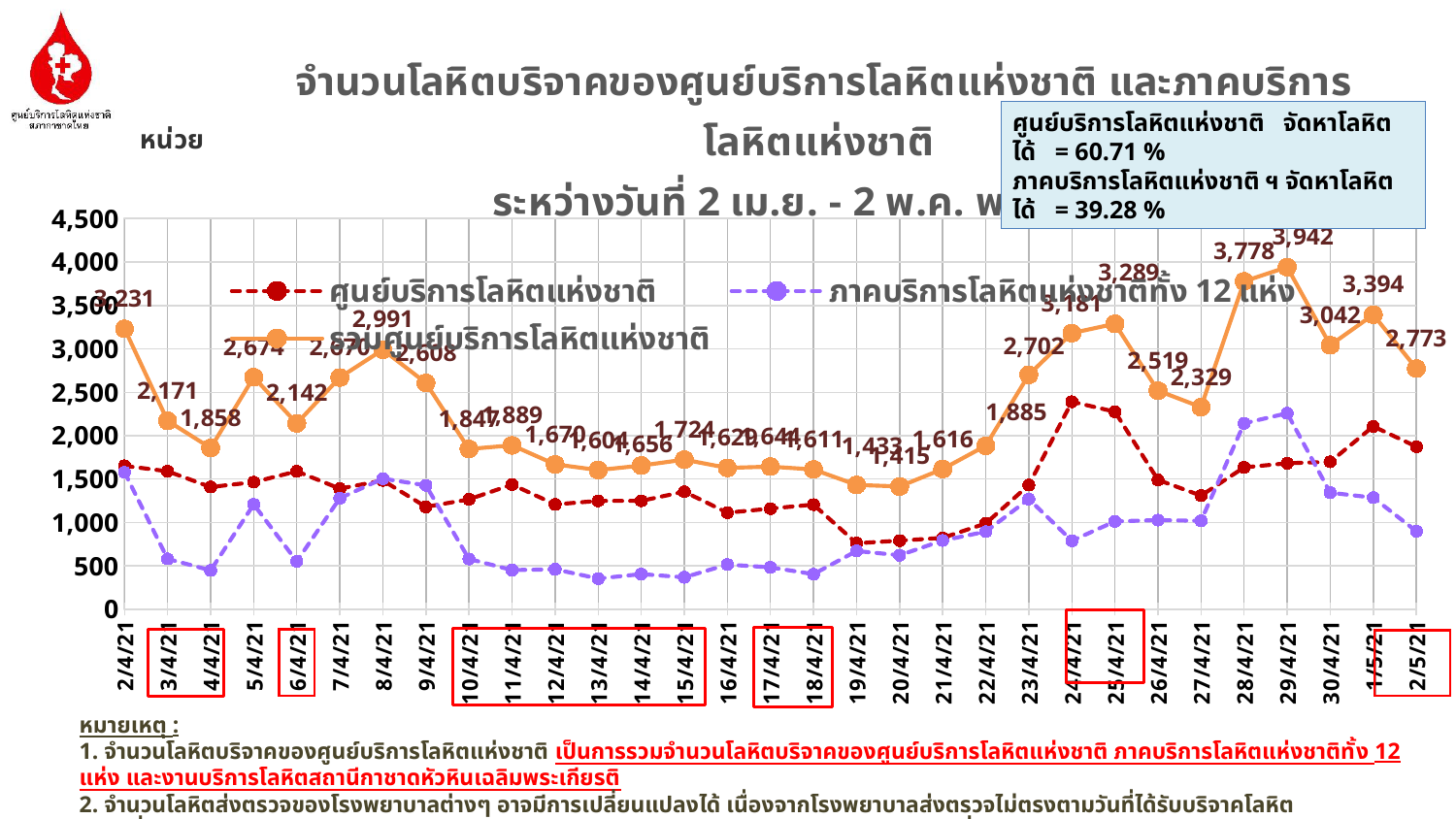
What type of chart is shown on the slide? line chart On which date does the รวมศูนย์บริการโลหิตแห่งชาติ series reach its highest value? 29/4/21 Which date has the larger รวมศูนย์บริการโลหิตแห่งชาติ value, 3/4/21 or 4/4/21? 3/4/21 What is the value of the รวมศูนย์บริการโลหิตแห่งชาติ series on 2/4/21? 3,231 Is the value of the ภาคบริการโลหิตแห่งชาติทั้ง 12 แห่ง series on 13/4/21 greater or less than 500? less What is the value of the รวมศูนย์บริการโลหิตแห่งชาติ series on 23/4/21? 2,702 What is the difference between the รวมศูนย์บริการโลหิตแห่งชาติ values on 29/4/21 and 28/4/21? 164 Is the value of the ศูนย์บริการโลหิตแห่งชาติ series on 24/4/21 greater or less than 2,000? greater On which date does the รวมศูนย์บริการโลหิตแห่งชาติ series reach its lowest value? 20/4/21 What is the value of the รวมศูนย์บริการโลหิตแห่งชาติ series on 29/4/21? 3,942 How many dates are plotted along the x axis? 31 How many series does the legend list? 3